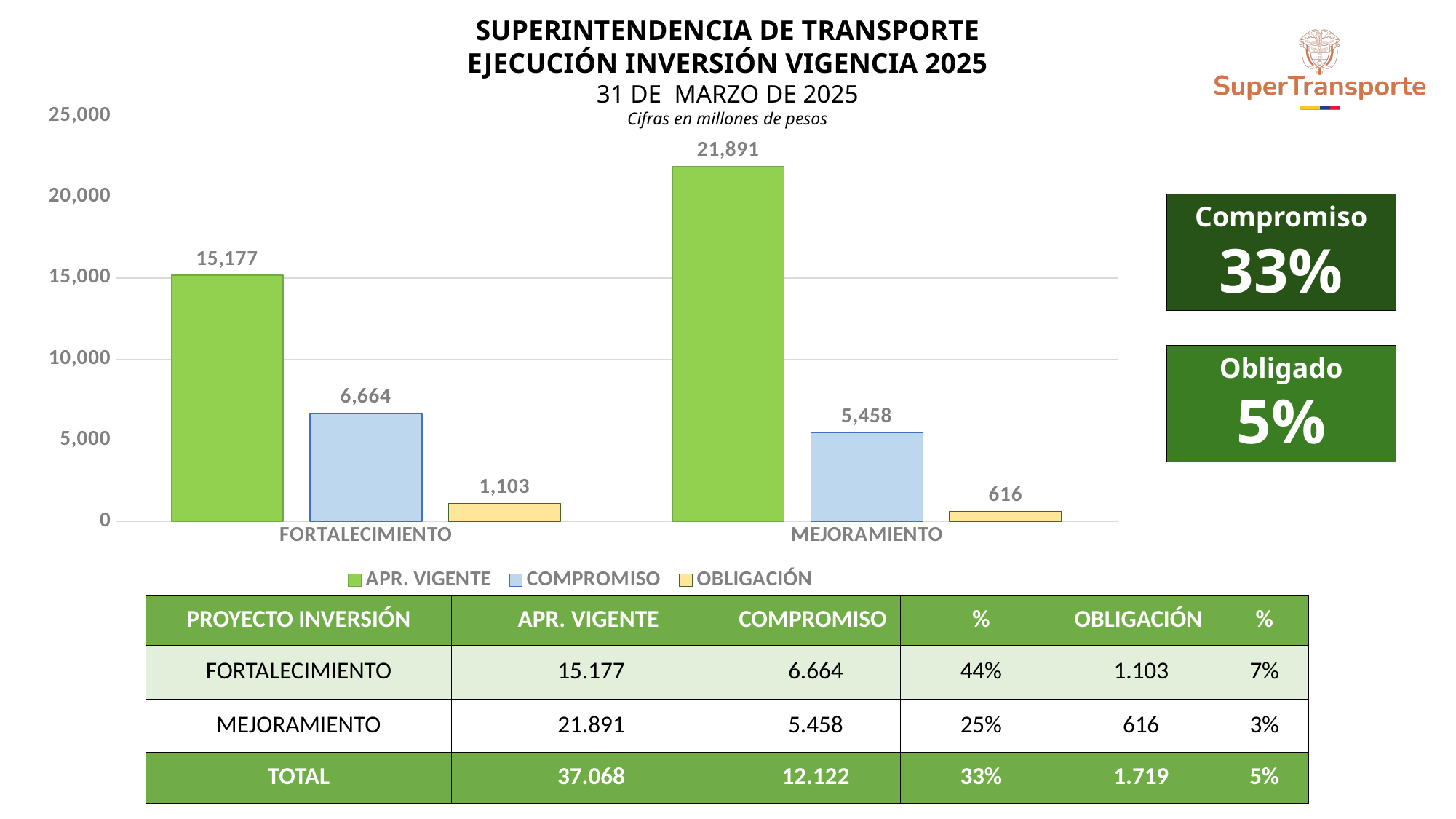
What is the APR. VIGENTE value for MEJORAMIENTO in the chart? 21,891 Is the APR. VIGENTE value for MEJORAMIENTO greater or less than 20,000? greater What is the OBLIGACIÓN value for MEJORAMIENTO in the chart? 616 What type of chart is shown on the slide? Bar chart What is the difference between the APR. VIGENTE values for MEJORAMIENTO and FORTALECIMIENTO in the chart? 6,714 Which is larger in the chart: the COMPROMISO value for FORTALECIMIENTO or for MEJORAMIENTO? FORTALECIMIENTO Which category has the lower OBLIGACIÓN bar in the chart? MEJORAMIENTO What is the COMPROMISO value for FORTALECIMIENTO in the chart? 6,664 How many series does the chart legend list? 3 How many categories are shown on the x axis of the chart? 2 Which colour represents the OBLIGACIÓN series in the chart? Yellow Which category has the higher APR. VIGENTE bar in the chart? MEJORAMIENTO